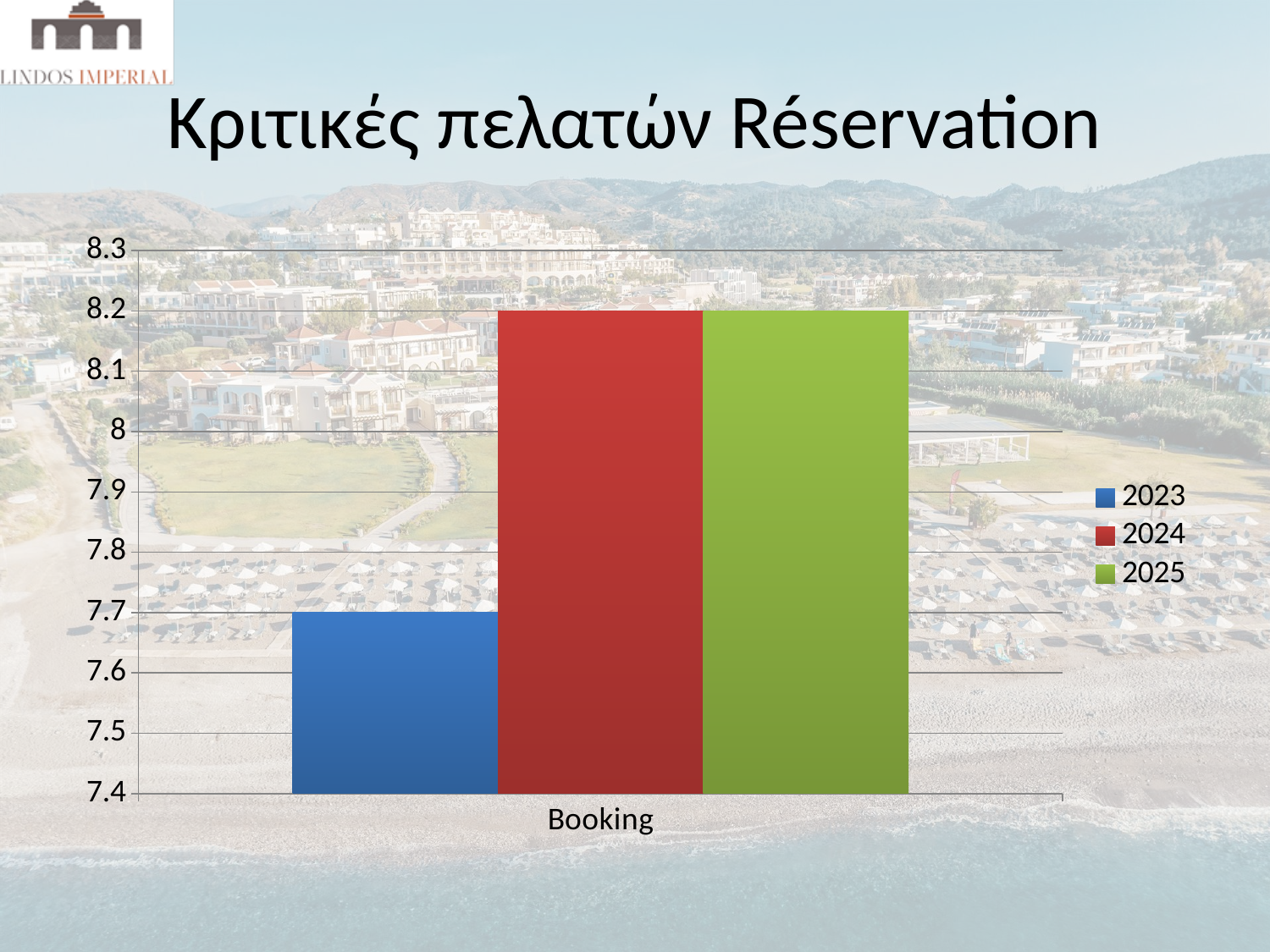
How many categories are shown on the x axis? 1 How many series does the legend list? 3 What is the value for 2025 in the Booking category? 8.2 What is the value for 2023 in the Booking category? 7.7 What is the difference between the 2024 and 2023 values for Booking? 0.5 Which is larger for Booking, the value for 2023 or the value for 2025? 2025 Which year has the lowest value for Booking? 2023 Is the value for 2023 greater or less than 8? less What is the value for 2024 in the Booking category? 8.2 Is the value for 2024 greater or less than 8? greater What kind of chart is shown on the slide? bar chart Which series is shown in red in the legend? 2024